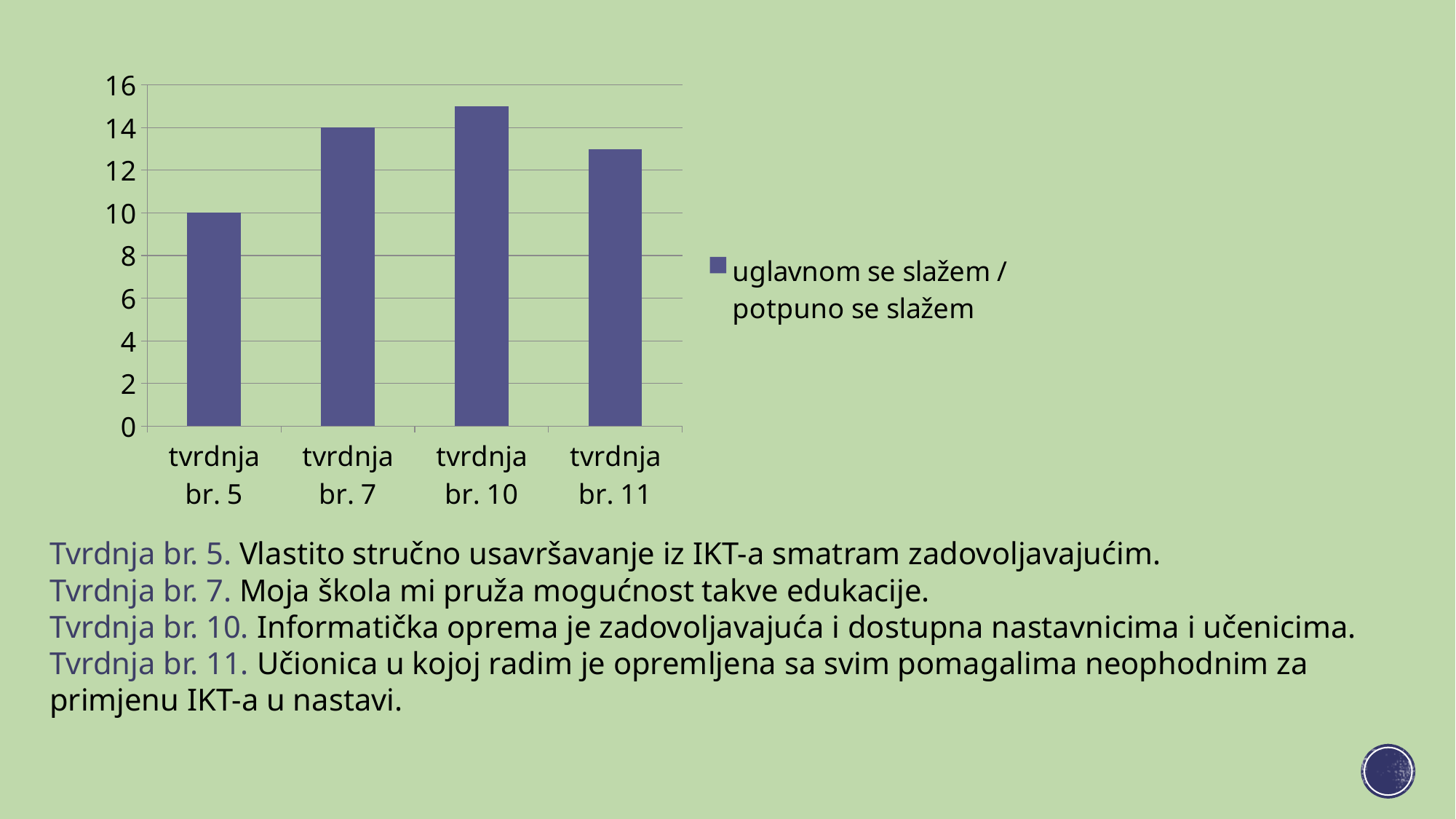
Is the value for tvrdnja br. 11 greater or less than 14? less What is the difference between the values for tvrdnja br. 7 and tvrdnja br. 5? 4 What is the value for tvrdnja br. 7? 14 Is the value for tvrdnja br. 10 greater or less than 14? greater How many series does the legend list? 1 How many categories are shown on the x axis? 4 Which category has the lowest bar? tvrdnja br. 5 What is the value for tvrdnja br. 5? 10 Which category has the highest bar? tvrdnja br. 10 Is the value for tvrdnja br. 11 greater or less than 12? greater What kind of chart is shown on the slide? bar chart Which is larger, the value for tvrdnja br. 11 or the value for tvrdnja br. 5? tvrdnja br. 11